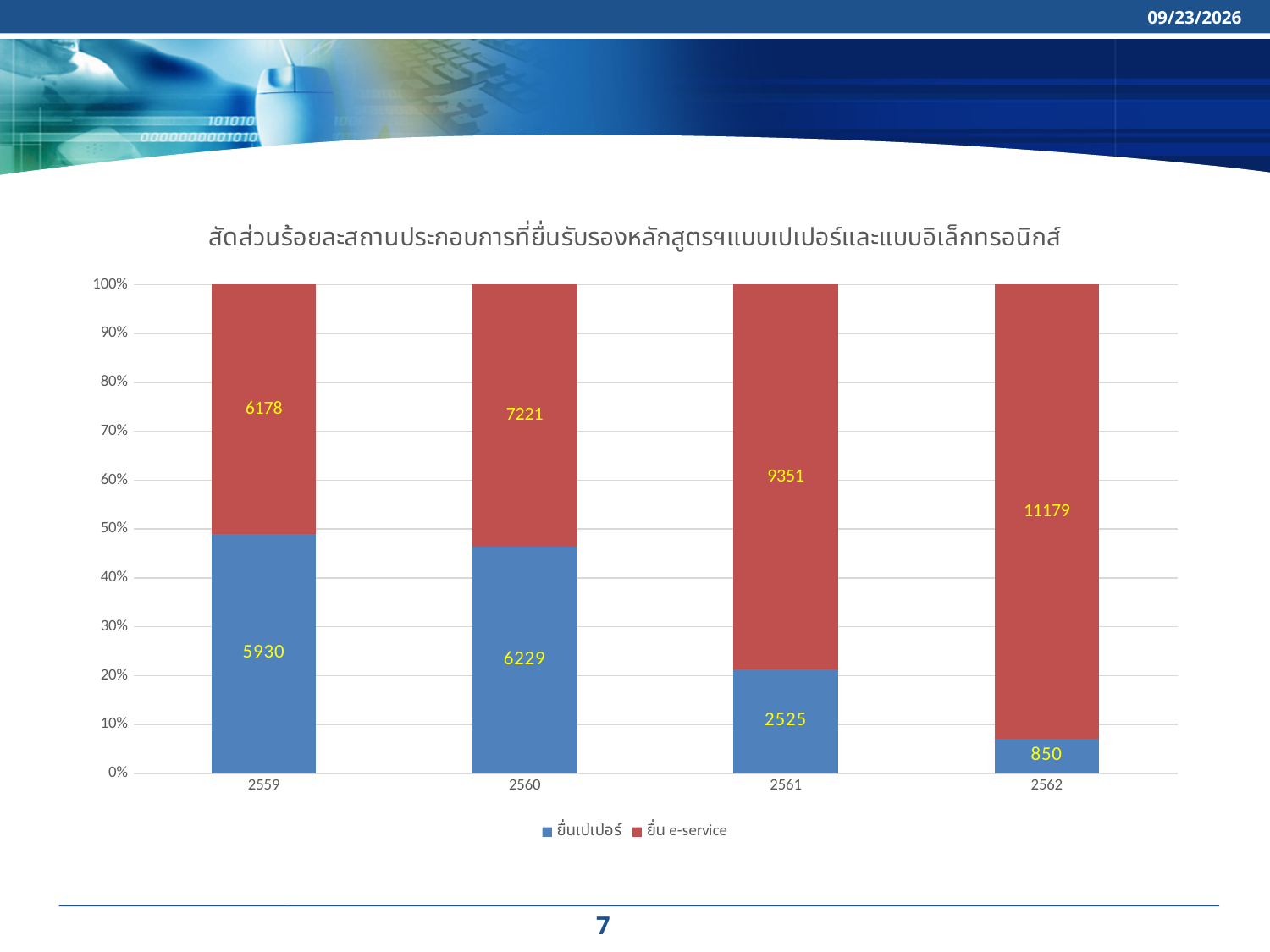
Which year has the lowest value for ยื่นเปเปอร์? 2562 Is the share of ยื่นเปเปอร์ in 2561 greater or less than 30%? less What kind of chart is shown on the slide? Stacked bar chart How many years are shown on the x axis? 4 Which is larger in 2559: ยื่นเปเปอร์ or ยื่น e-service? ยื่น e-service What is the difference between ยื่น e-service and ยื่นเปเปอร์ in 2560? 992 What is the value of ยื่น e-service for 2562? 11179 Which year has the highest value for ยื่น e-service? 2562 How many series does the legend list? 2 What is the value of ยื่นเปเปอร์ for 2559? 5930 What is the value of ยื่น e-service for 2561? 9351 What is the total of the two labelled values for 2562? 12029